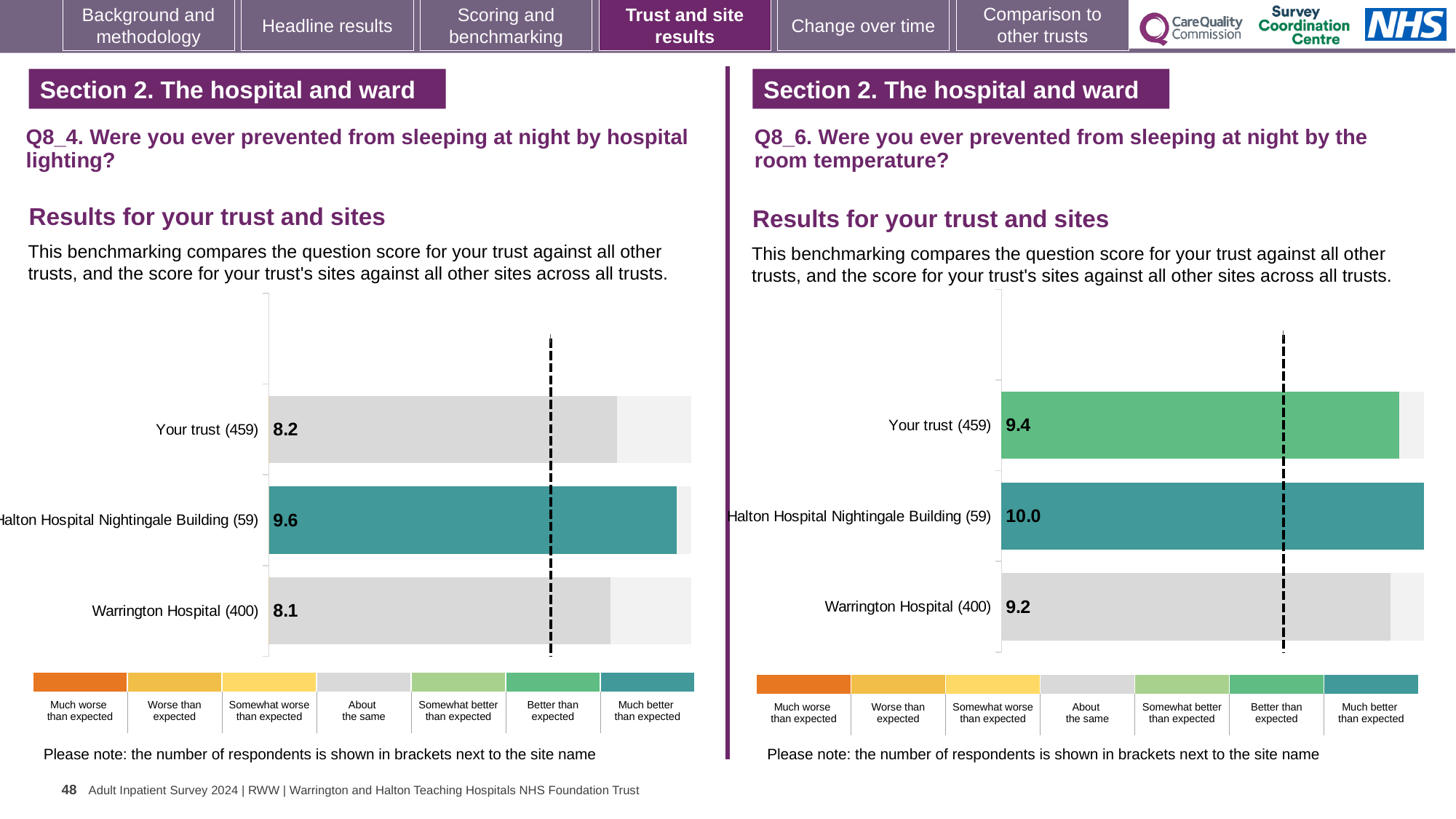
In the Q8_4 chart (hospital lighting), which site or trust has the highest score? Halton Hospital Nightingale Building (59) In the Q8_4 chart (hospital lighting), what is the score for Halton Hospital Nightingale Building (59)? 9.6 In the Q8_4 chart (hospital lighting), what is the score for Warrington Hospital (400)? 8.1 In the Q8_6 chart (room temperature), what is the score for Warrington Hospital (400)? 9.2 What type of chart is used in the Q8_6 chart (room temperature)? Bar chart In the Q8_6 chart (room temperature), which site or trust has the lowest score? Warrington Hospital (400) In the Q8_6 chart (room temperature), what is the difference between the scores for Your trust and Warrington Hospital? 0.2 How many bars are plotted in the Q8_4 chart (hospital lighting)? 3 In the Q8_6 chart (room temperature), what is the score for Your trust (459)? 9.4 In the Q8_4 chart (hospital lighting), what is the difference between the scores for Halton Hospital Nightingale Building and Warrington Hospital? 1.5 In the Q8_4 chart (hospital lighting), what is the score for Your trust (459)? 8.2 In the Q8_6 chart (room temperature), what is the score for Halton Hospital Nightingale Building (59)? 10.0